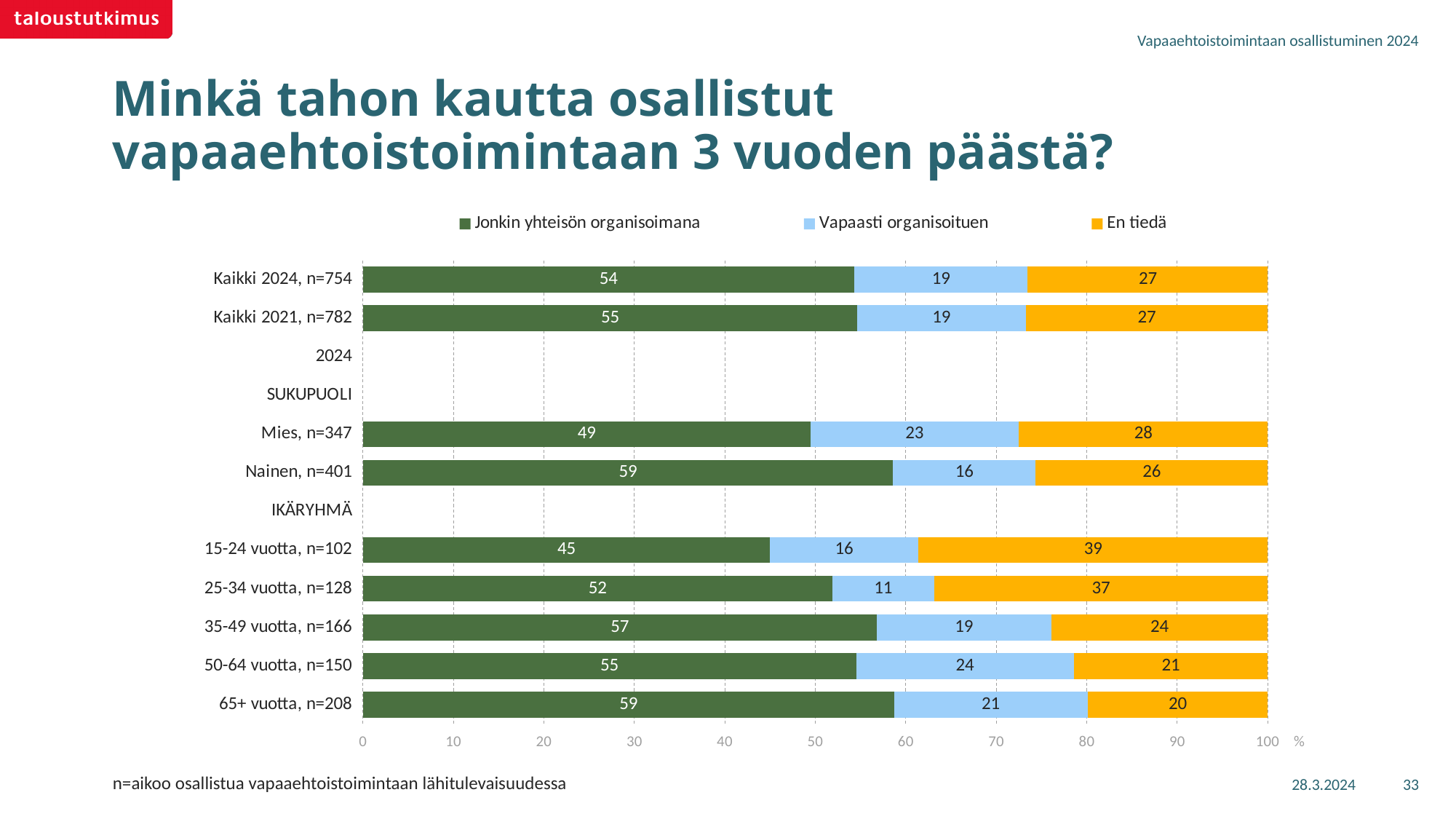
What is the value of 'En tiedä' for '25-34 vuotta, n=128'? 37 How many bars with data are plotted in the chart? 9 What is the total of the stacked bar for 'Kaikki 2024, n=754'? 100 Which category has the lowest value for 'Vapaasti organisoituen'? 25-34 vuotta, n=128 What is the difference between the 'Jonkin yhteisön organisoimana' values for 'Nainen, n=401' and 'Mies, n=347'? 10 Which category has the highest value for 'En tiedä'? 15-24 vuotta, n=102 What is the value of 'Jonkin yhteisön organisoimana' for 'Mies, n=347'? 49 Which category has the lowest value for 'Jonkin yhteisön organisoimana'? 15-24 vuotta, n=102 Which is larger: the 'En tiedä' value for '35-49 vuotta, n=166' or for '50-64 vuotta, n=150'? 35-49 vuotta, n=166 What kind of chart is shown on the slide? Stacked bar chart How many series does the legend list? 3 What is the value of 'Vapaasti organisoituen' for '50-64 vuotta, n=150'? 24